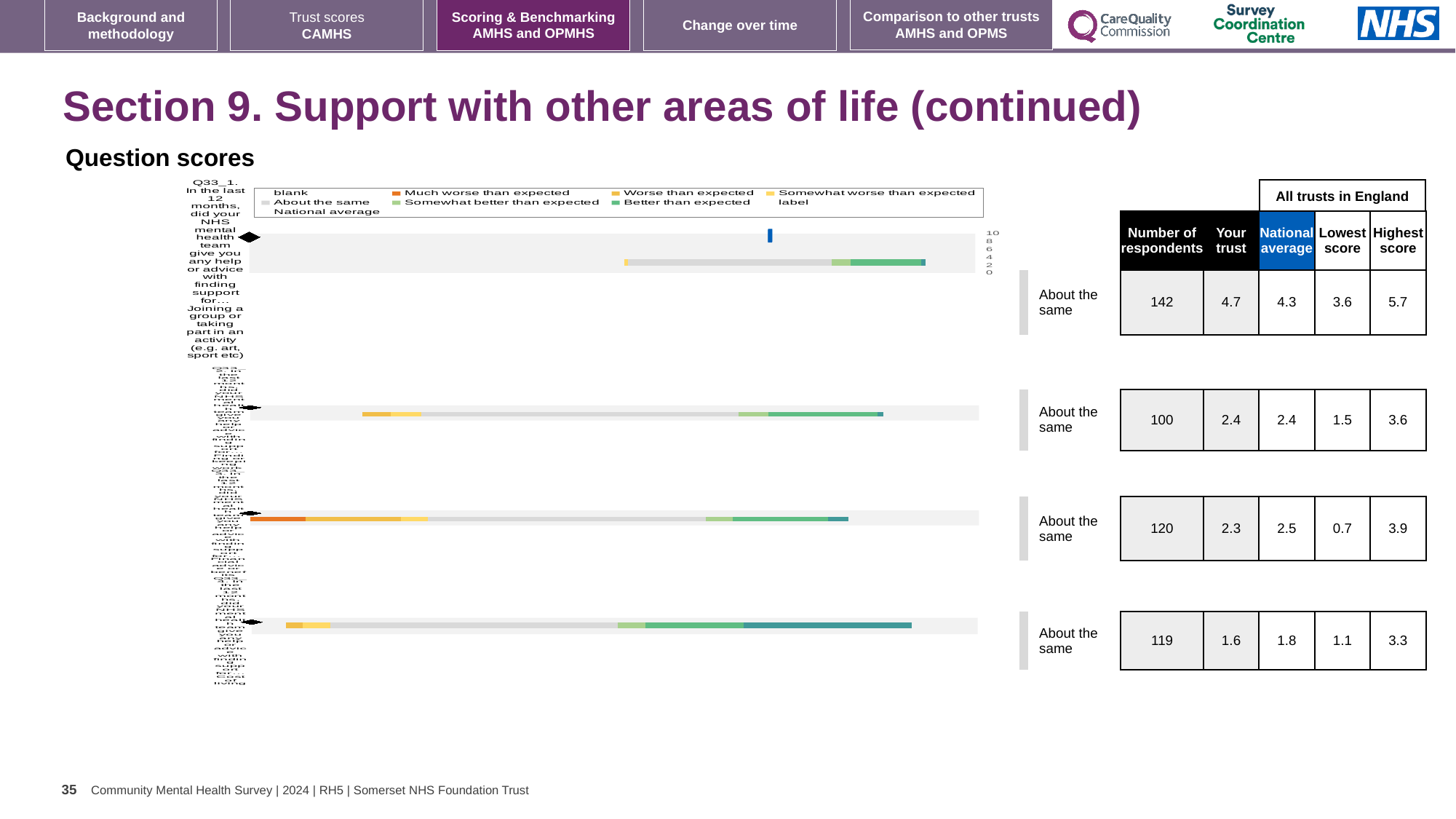
Which legend entry is shown in dark orange in the chart? Much worse than expected How many entries does the chart's legend list? 9 Which legend entry is shown in light grey in the chart? About the same What is the question number of the first (top) bar in the chart? Q33_1 Are the bars in the chart oriented horizontally or vertically? horizontally How many bars (question rows) are plotted in the chart? 4 What kind of chart is shown under 'Question scores'? bar chart